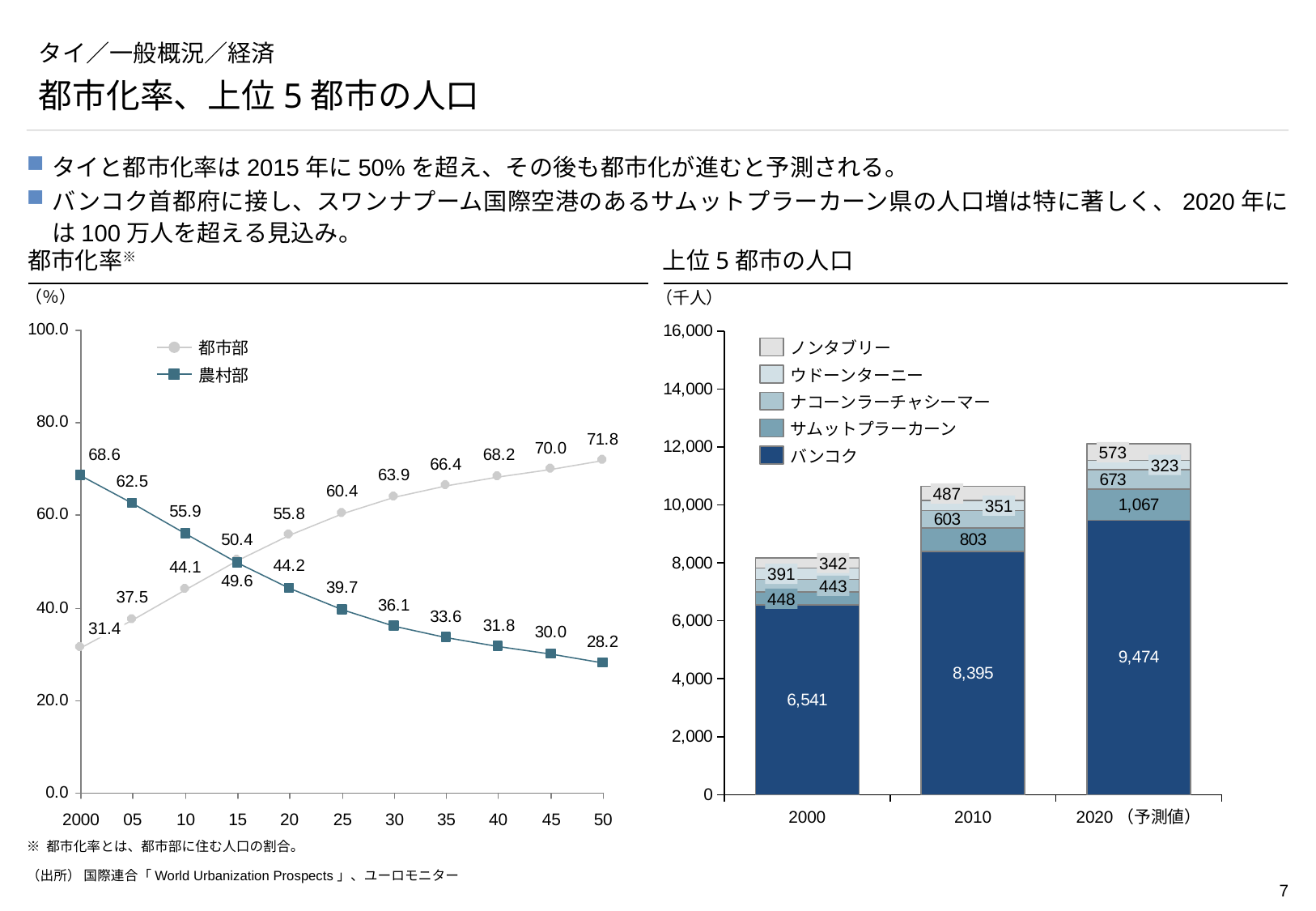
In the 都市化率 chart on the left, does the 農村部 series rise or fall from 2000 to 2050? fall In the 上位5都市の人口 chart on the right, how many series does the legend list? 5 In the 上位5都市の人口 chart on the right, what is the value for バンコク in 2010? 8,395 In the 上位5都市の人口 chart on the right, what is the value for サムットプラーカーン in 2020 (予測値)? 1,067 In the 都市化率 chart on the left, what is the value for 都市部 in 2015 (15)? 50.4 In the 都市化率 chart on the left, what is the difference between 都市部 and 農村部 in 2050 (50)? 43.6 What kind of chart is the 都市化率 chart on the left? line chart In the 上位5都市の人口 chart on the right, is the total height of the 2020 (予測値) bar greater or less than 12,000? greater In the 都市化率 chart on the left, what is the value for 都市部 in 2000? 31.4 In the 上位5都市の人口 chart on the right, what is the difference between the バンコク values for 2020 (予測値) and 2000? 2,933 In the 都市化率 chart on the left, what is the value for 農村部 in 2050 (50)? 28.2 In the 都市化率 chart on the left, how many series does the legend list? 2